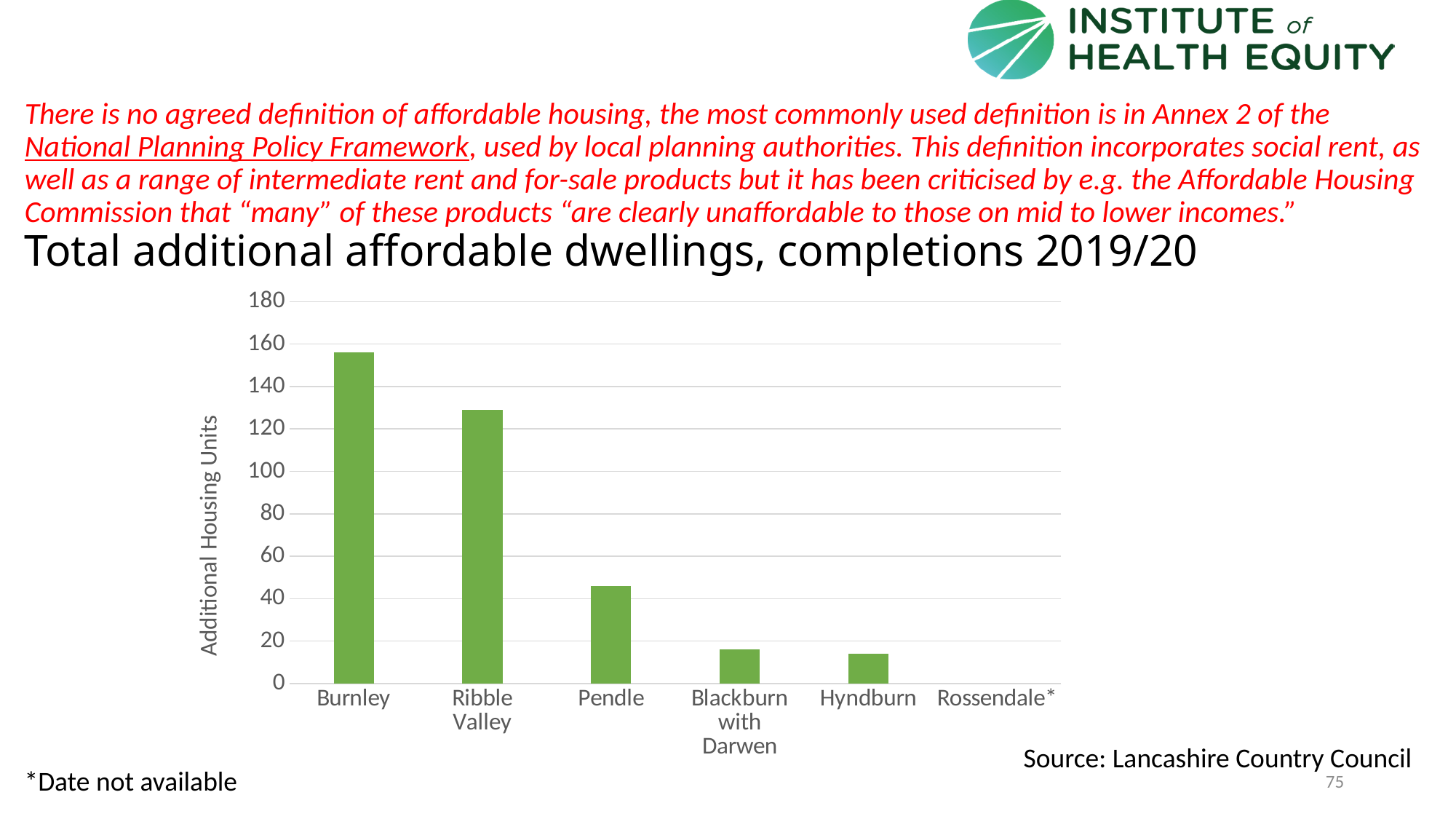
What kind of chart is shown on the slide? bar chart Is the value for Pendle greater or less than 60? less What is the label on the vertical axis of the chart? Additional Housing Units Which has a larger value, Pendle or Blackburn with Darwen? Pendle Which has a larger value, Burnley or Ribble Valley? Burnley Is the value for Blackburn with Darwen greater or less than 20? less Is the value for Ribble Valley greater or less than 120? greater Do the bar values rise or fall moving from left to right along the x axis? fall Which category has the highest number of additional affordable dwellings? Burnley How many categories are shown on the x axis of the chart? 6